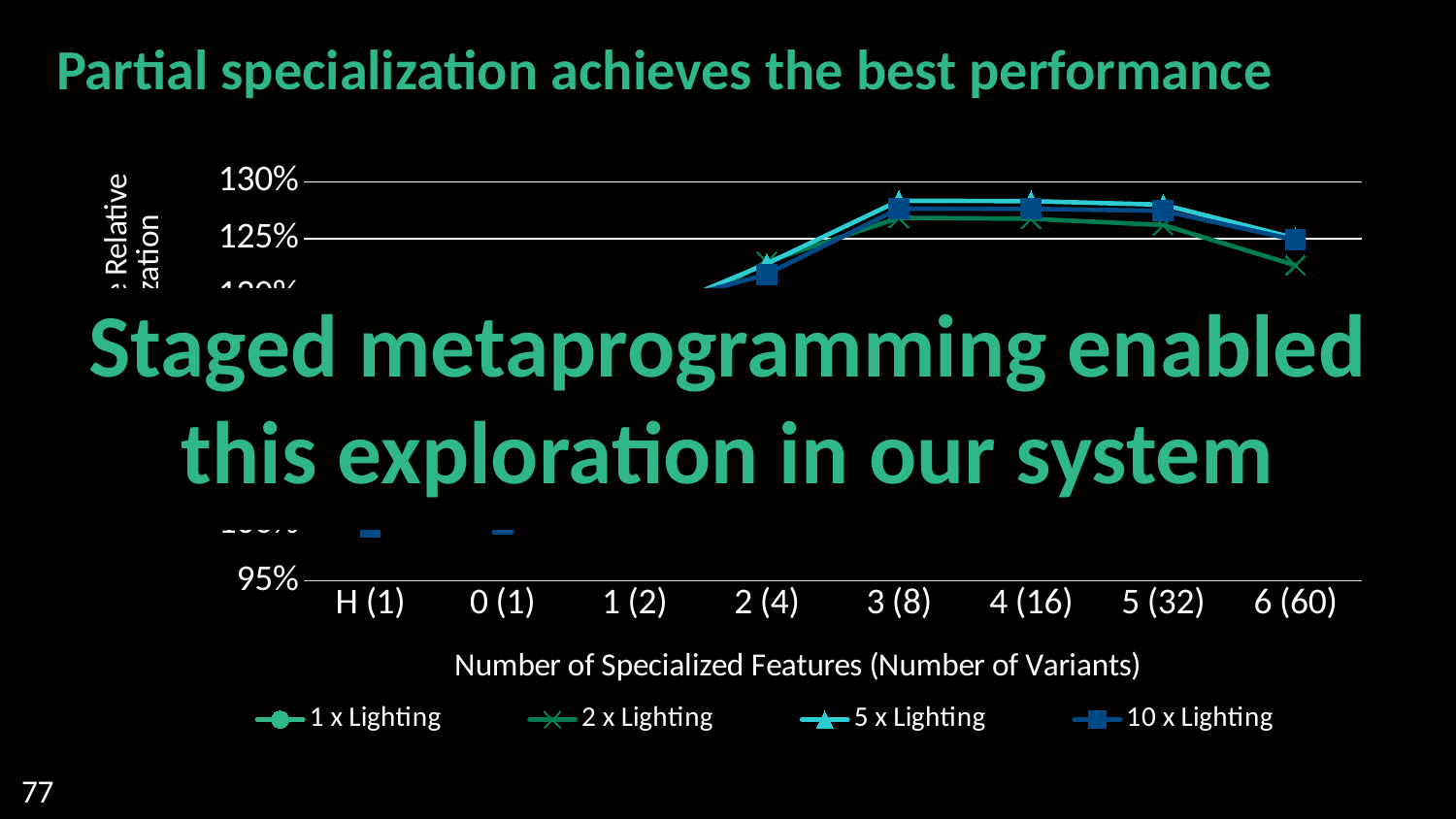
Is the value for 10 x Lighting at 2 (4) greater or less than 125%? less Is the value for 5 x Lighting at 5 (32) greater or less than 130%? less Is the value for 5 x Lighting at 3 (8) greater or less than 125%? greater What is the last category label on the x axis of the chart? 6 (60) Does the 2 x Lighting line rise or fall from 3 (8) to 6 (60)? fall What is the x-axis title of the chart? Number of Specialized Features (Number of Variants) What kind of chart is shown on the slide? line chart Which series are listed in the chart legend? 1 x Lighting, 2 x Lighting, 5 x Lighting, 10 x Lighting How many series does the chart legend list? 4 At 6 (60), which series has the higher value: 10 x Lighting or 2 x Lighting? 10 x Lighting How many categories are shown on the x axis of the chart? 8